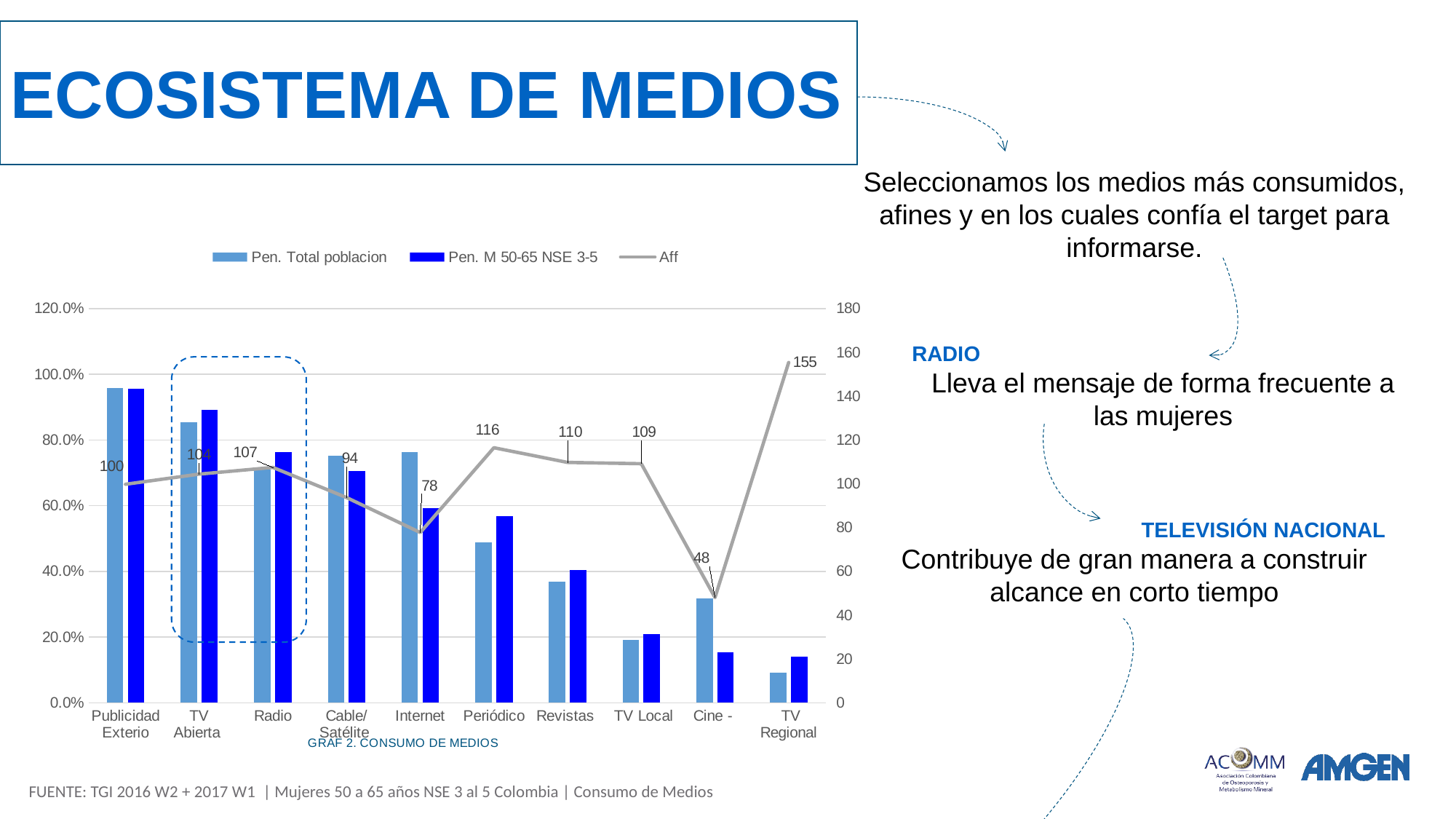
What is the difference between the Aff value for TV Regional and the Aff value for Cine -? 107 Which category has the lowest Aff value? Cine - What is the Aff value for Internet? 78 What is the Aff value for Periódico? 116 Which category has the highest Aff value? TV Regional Is the Pen. M 50-65 NSE 3-5 value for TV Local greater or less than 40.0%? less How many media categories are shown on the x axis? 10 Which has a higher Aff value, Revistas or TV Local? Revistas What is the Aff value for Radio? 107 What is the caption printed below the chart? GRAF 2. CONSUMO DE MEDIOS Is the Pen. Total poblacion value for Publicidad Exterio greater or less than 80.0%? greater How many series does the legend list? 3